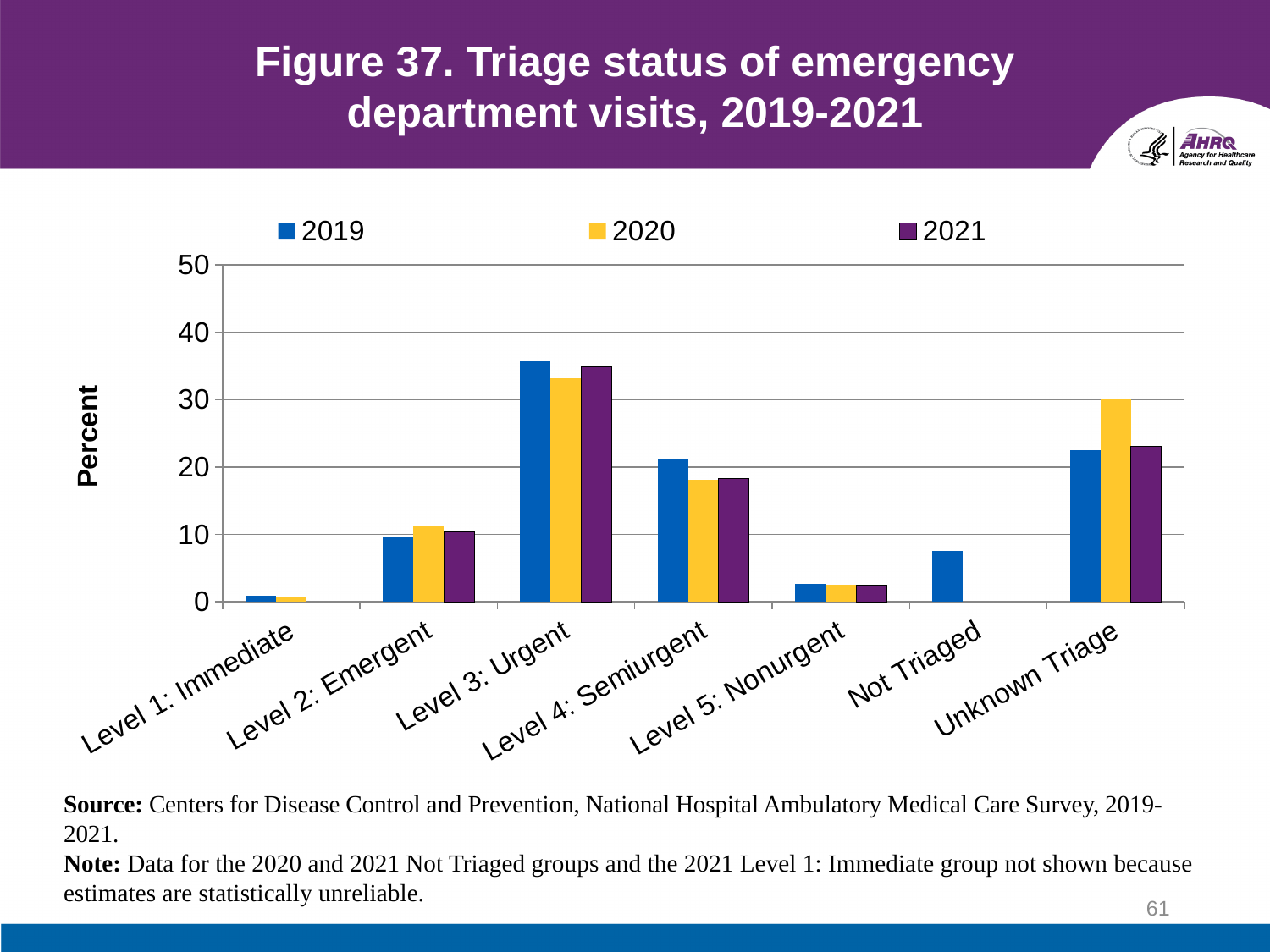
Is the 2019 value for Not Triaged greater or less than 10? less How many series does the legend list? 3 Which triage status has the highest value for 2020? Level 3: Urgent Is the 2019 value for Level 3: Urgent greater or less than 30? greater For Unknown Triage, which year has the larger value, 2019 or 2020? 2020 Which triage status has the highest value for 2019? Level 3: Urgent What kind of chart is shown on the slide? bar chart What is the label on the y axis? Percent For Level 4: Semiurgent, which year has the larger value, 2019 or 2020? 2019 How many triage status categories are shown on the x axis? 7 Which triage status has the lowest value for 2019? Level 1: Immediate Is the 2020 value for Unknown Triage greater or less than 20? greater